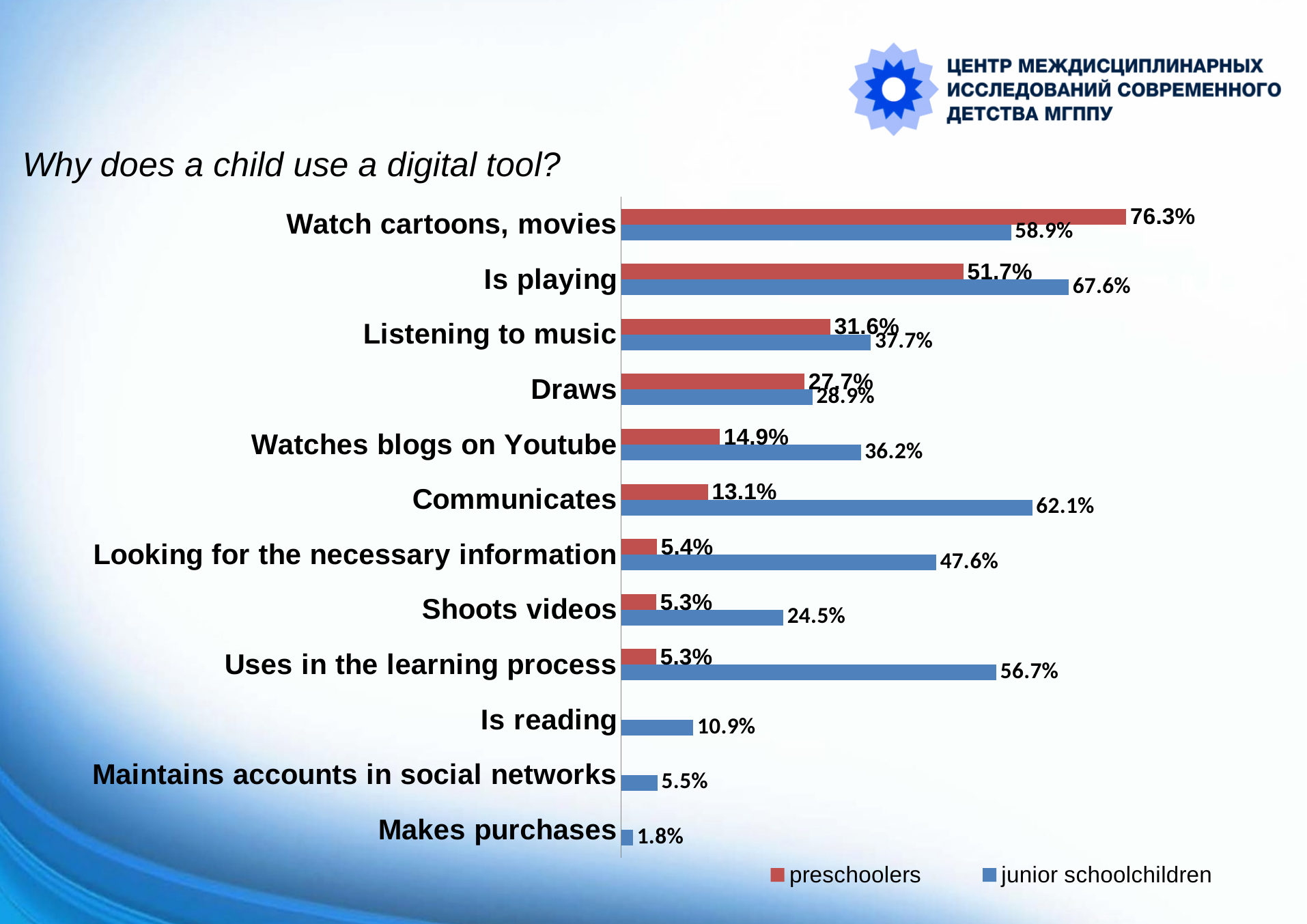
What is the value for preschoolers for 'Watches blogs on Youtube'? 14.9% What is the difference between junior schoolchildren and preschoolers for 'Communicates'? 49.0% How many categories are shown on the chart? 12 How many series does the legend list? 2 What is the difference between preschoolers and junior schoolchildren for 'Watch cartoons, movies'? 17.4% For 'Is playing', which group has the larger value, preschoolers or junior schoolchildren? junior schoolchildren Which category has the lowest value for junior schoolchildren? Makes purchases Which category has the highest value for junior schoolchildren? Is playing What percentage of junior schoolchildren use a digital tool for communicating? 62.1% What type of chart is shown on the slide? bar chart What percentage of preschoolers use a digital tool to watch cartoons and movies? 76.3% What is the value for junior schoolchildren for 'Uses in the learning process'? 56.7%